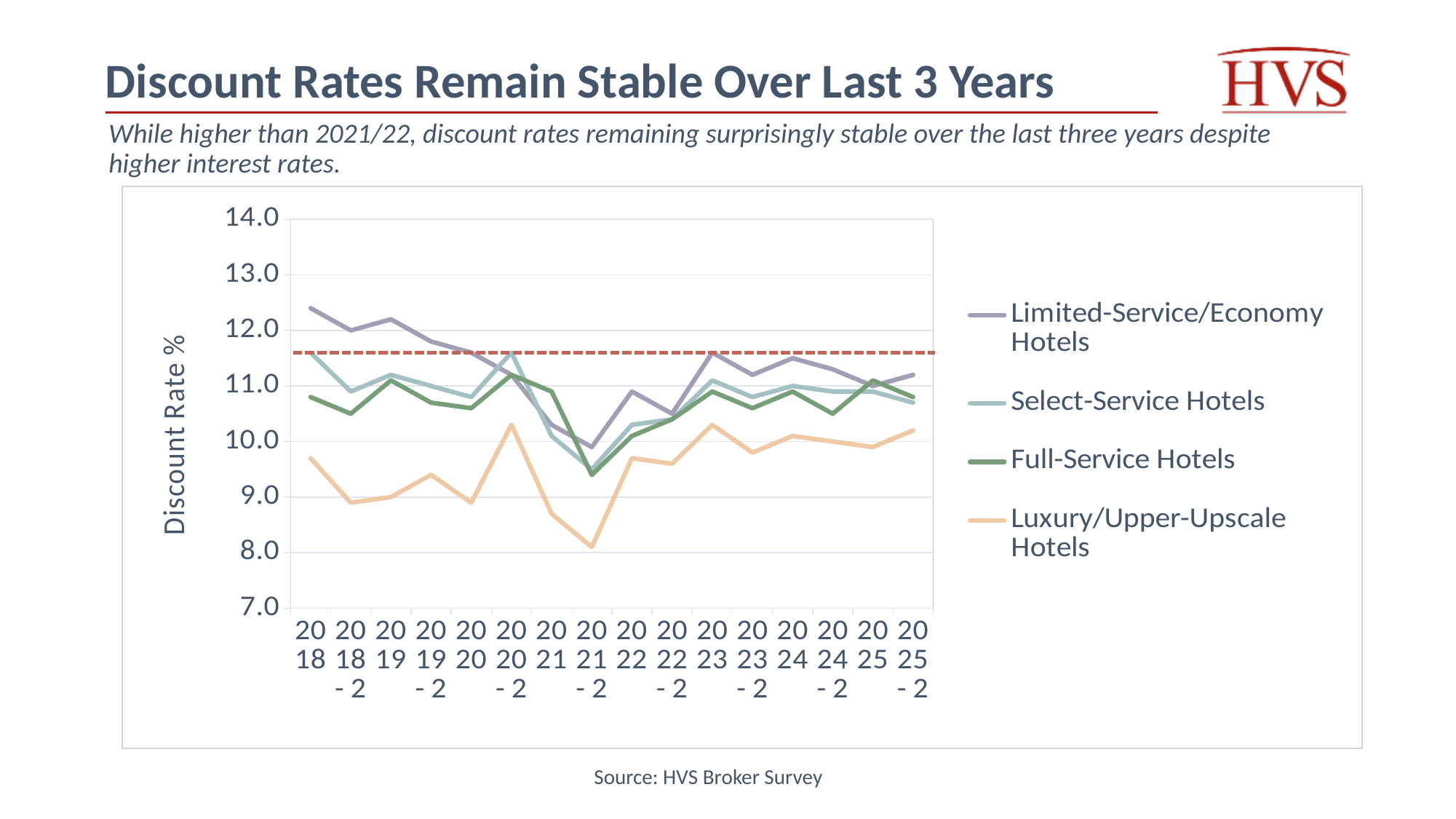
Which series has the highest discount rate in 2018? Limited-Service/Economy Hotels What kind of chart is shown on the slide? Line chart What is the label on the y axis? Discount Rate % Is the value for Luxury/Upper-Upscale Hotels in 2021-2 greater or less than 9.0? less How many time points are shown along the x axis? 16 How many series does the legend list? 4 Is the value for Full-Service Hotels in 2021-2 greater or less than 10.0? less What is the title of the slide's chart? Discount Rates Remain Stable Over Last 3 Years Which is larger in 2025-2: the value for Full-Service Hotels or for Luxury/Upper-Upscale Hotels? Full-Service Hotels Does the Limited-Service/Economy Hotels line rise or fall from 2018 to 2021-2? Fall Which series has the lowest discount rate across the whole period? Luxury/Upper-Upscale Hotels Is the value for Limited-Service/Economy Hotels in 2018 greater or less than 12.0? greater